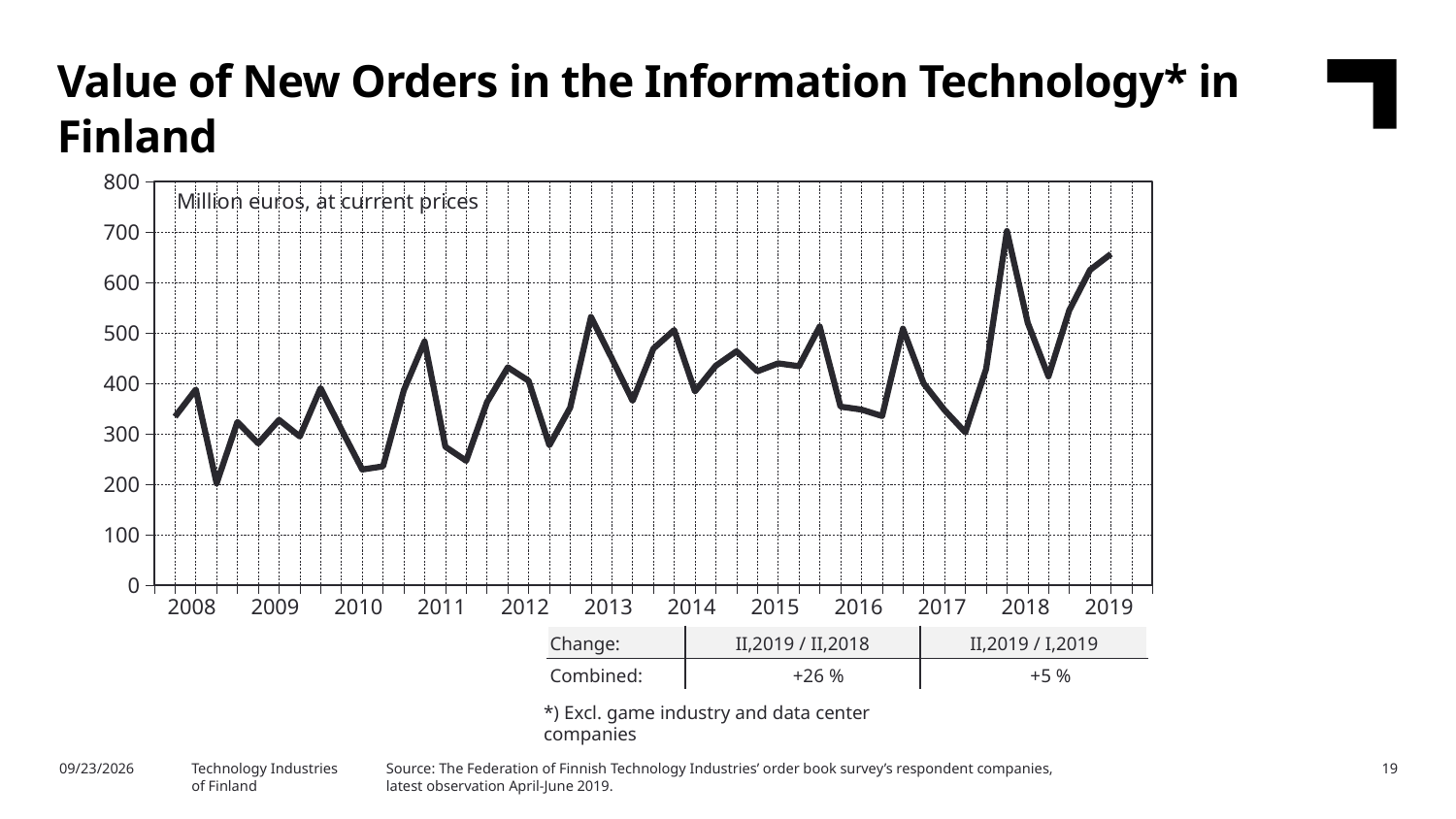
Is the lowest value reached in 2008 greater or less than 300? less How many lines (series) are plotted on the chart? 1 Is the highest value reached around 2018 greater or less than 600? greater In what unit are the values on the chart expressed, according to the label inside the plot area? Million euros, at current prices How many years are labeled on the x axis of the chart? 12 What is the title of the chart on the slide? Value of New Orders in the Information Technology* in Finland Is the last plotted value, in 2019, greater or less than 600? greater Around which year does the line reach its highest point? 2018 What type of chart is shown on the slide? Line chart Around which year does the line reach its lowest point? 2008 According to the table below the chart, what is the combined change for II,2019 / II,2018? +26 % Does the line generally rise or fall between 2017 and 2019? rise